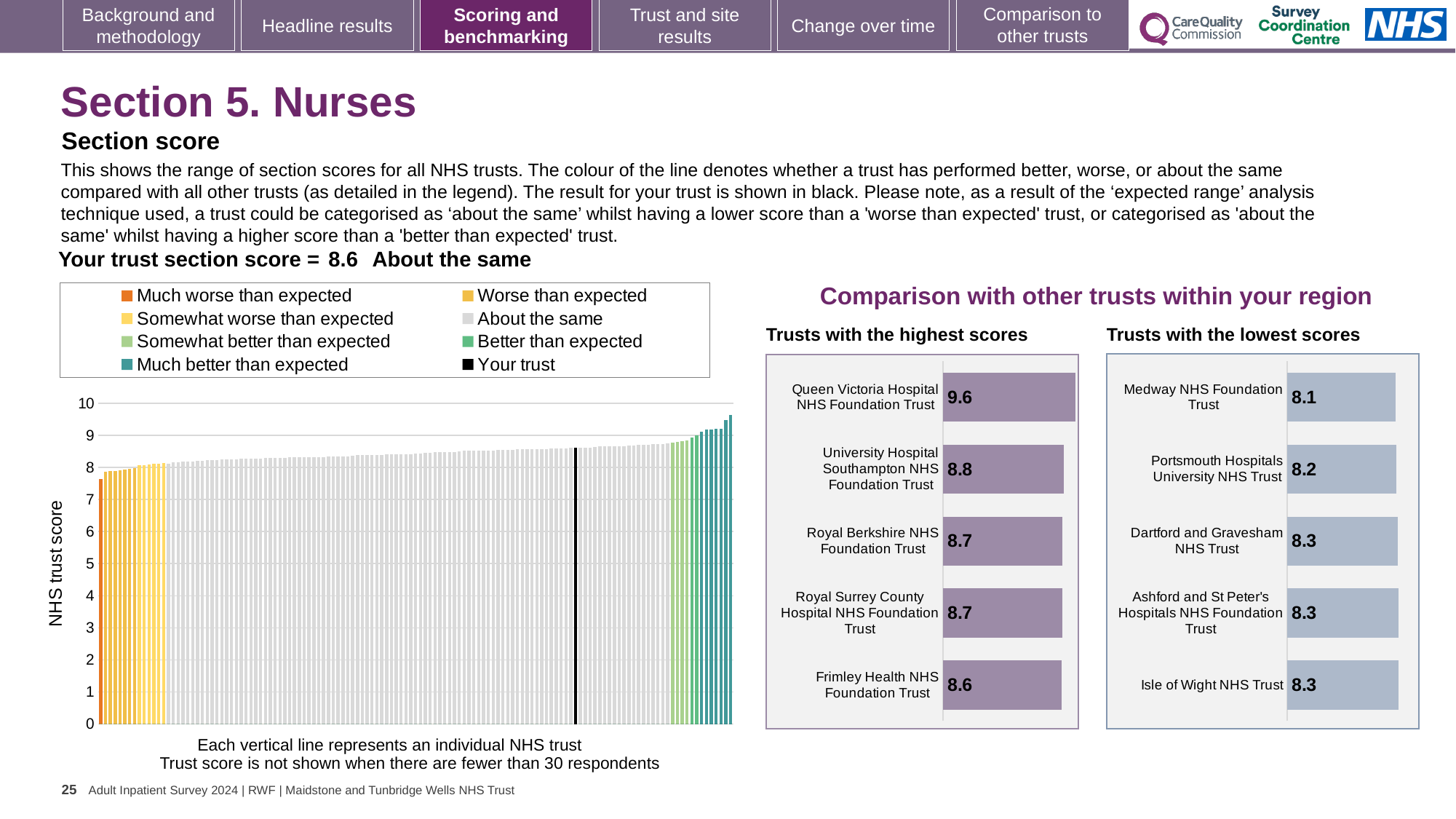
In the 'Trusts with the lowest scores' chart, which has the larger score: Portsmouth Hospitals University NHS Trust or Dartford and Gravesham NHS Trust? Dartford and Gravesham NHS Trust In the 'Trusts with the highest scores' chart, which trust has the highest score? Queen Victoria Hospital NHS Foundation Trust In the 'Trusts with the highest scores' chart, what is the score for Frimley Health NHS Foundation Trust? 8.6 In the 'Trusts with the lowest scores' chart, what is the difference between the scores of Isle of Wight NHS Trust and Medway NHS Foundation Trust? 0.2 How many trusts are shown in the 'Trusts with the highest scores' chart? 5 In the 'Trusts with the lowest scores' chart, which trust has the lowest score? Medway NHS Foundation Trust In the 'Trusts with the highest scores' chart, what is the difference between the scores of Queen Victoria Hospital NHS Foundation Trust and Frimley Health NHS Foundation Trust? 1.0 In the 'Trusts with the lowest scores' chart, what is the score for Medway NHS Foundation Trust? 8.1 In the 'Trusts with the highest scores' chart, what is the score for Queen Victoria Hospital NHS Foundation Trust? 9.6 What kind of chart is the 'Trusts with the lowest scores' chart? Bar chart In the NHS trust score chart on the left, what is the section score for your trust? 8.6 How many entries does the legend of the NHS trust score chart on the left list? 8